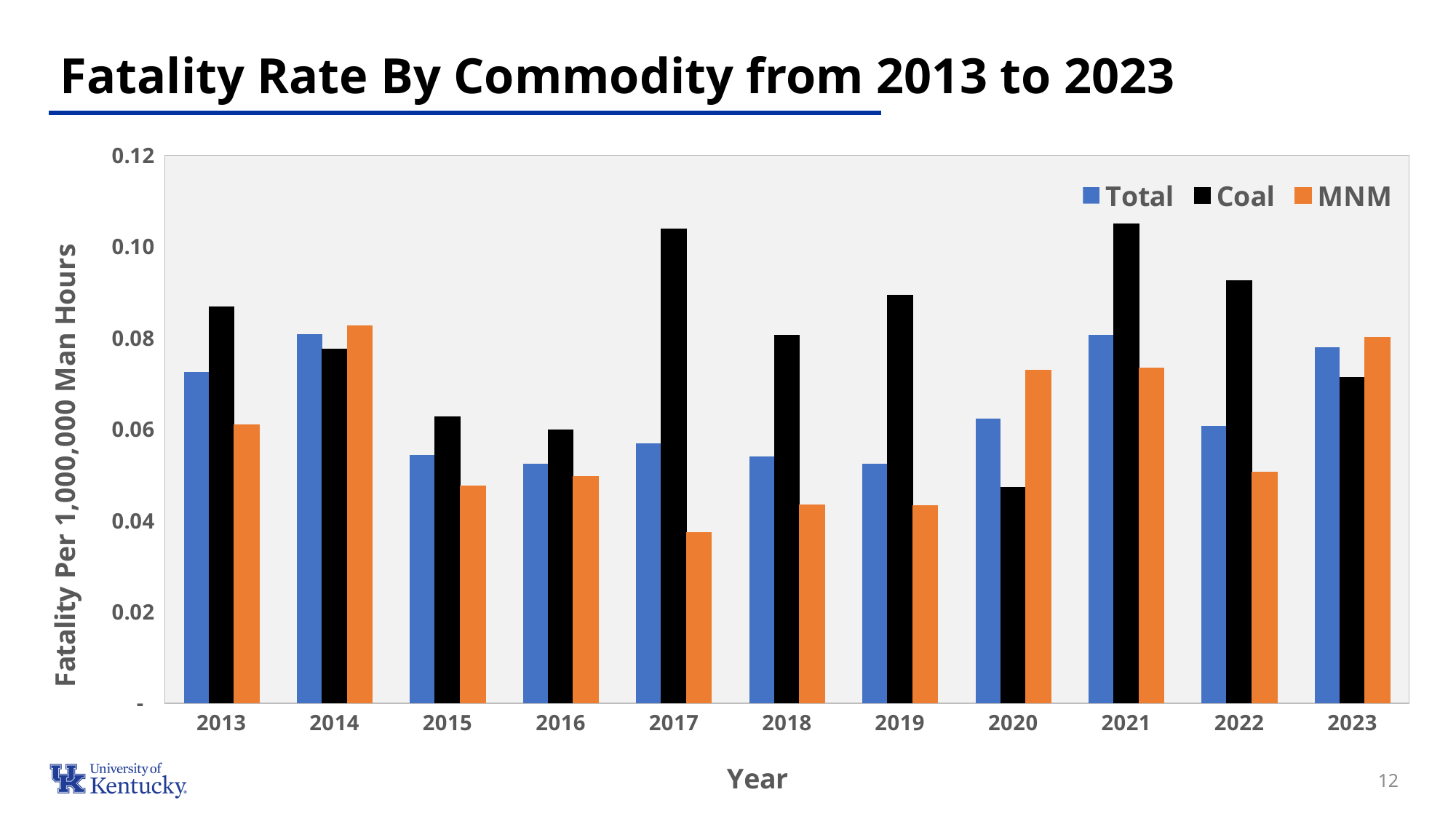
What is the label of the y axis? Fatality Per 1,000,000 Man Hours In which year is the MNM fatality rate lowest? 2017 Is the MNM value for 2017 greater or less than 0.04? less In which year is the Coal fatality rate lowest? 2020 What kind of chart is shown on the slide? Bar chart In 2019, which is larger, the Coal value or the Total value? Coal Is the Coal value for 2020 greater or less than 0.06? less In 2020, which is larger, the Coal value or the MNM value? MNM How many years are shown on the x axis? 11 Is the Coal value for 2017 greater or less than 0.10? greater How many series does the legend list? 3